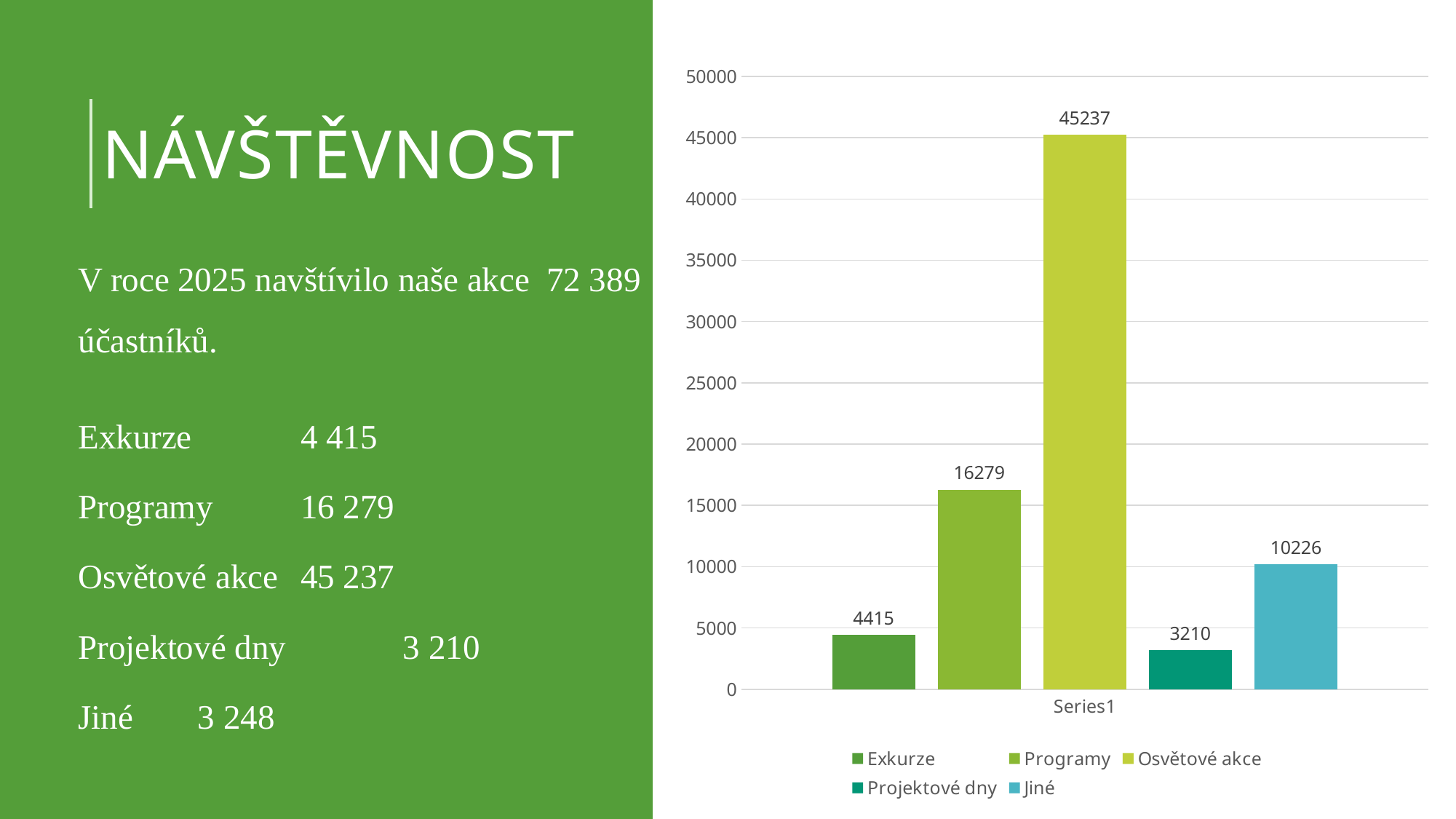
What is the value shown for Jiné in the chart? 10226 How many bars are plotted in the chart? 5 What is the difference between the values for Exkurze and Projektové dny in the chart? 1205 What is the difference between the values for Osvětové akce and Programy in the chart? 28958 How many entries does the chart legend list? 5 Which category has the highest value in the chart? Osvětové akce What is the value shown for Programy in the chart? 16279 What is the value shown for Projektové dny in the chart? 3210 Which category has the lowest value in the chart? Projektové dny What is the value shown for Osvětové akce in the chart? 45237 What kind of chart is shown on the slide? Bar chart Which is larger in the chart, the value for Jiné or the value for Exkurze? Jiné